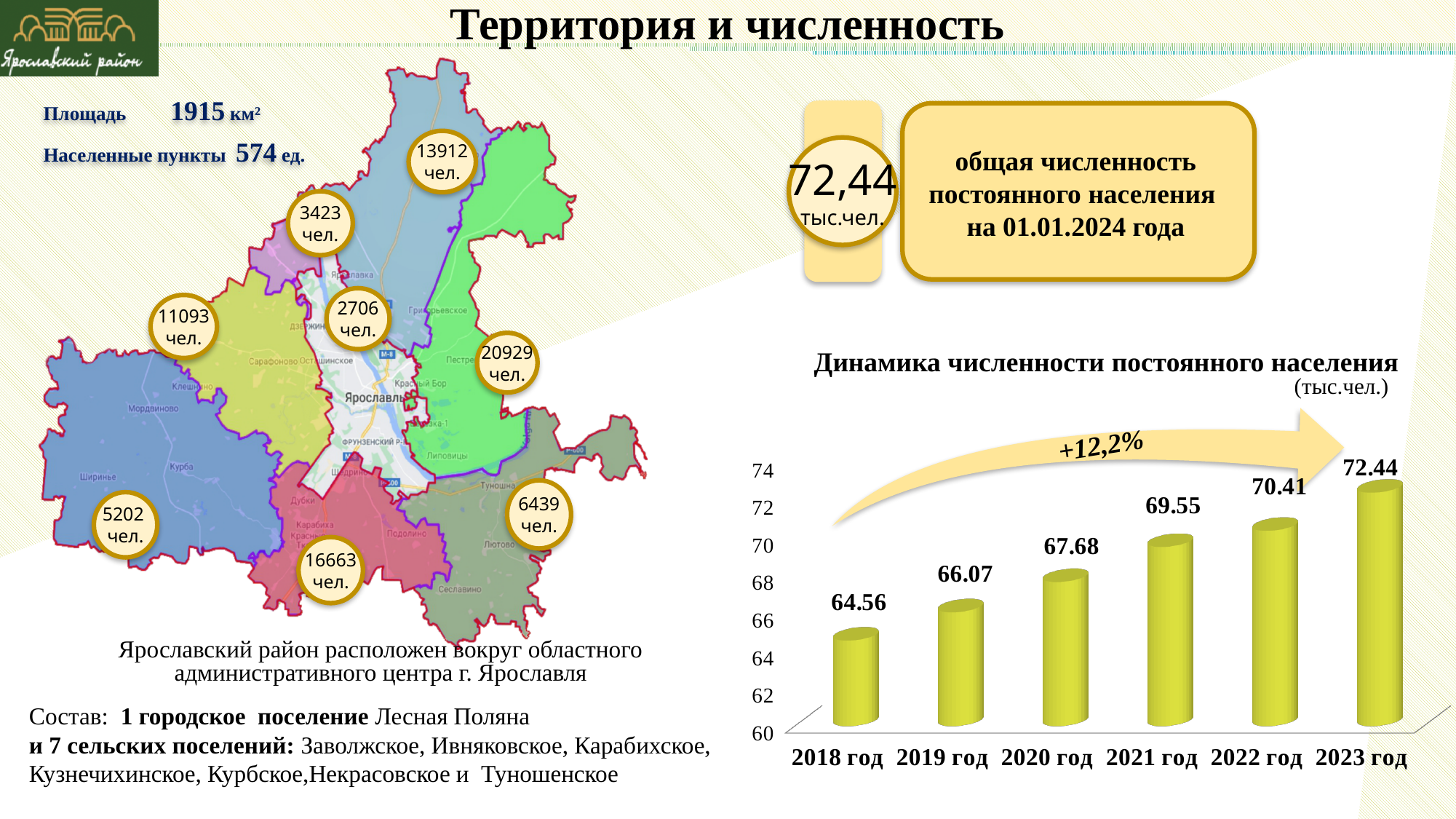
What kind of chart is 'Динамика численности постоянного населения'? bar chart In the chart 'Динамика численности постоянного населения', which is larger: the value for 2022 год or the value for 2020 год? 2022 год What is the value for 2021 год in the chart 'Динамика численности постоянного населения'? 69.55 What is the value for 2018 год in the chart 'Динамика численности постоянного населения'? 64.56 How many years are shown in the chart 'Динамика численности постоянного населения'? 6 Which year has the lowest value in the chart 'Динамика численности постоянного населения'? 2018 год Is the value for 2019 год in the chart 'Динамика численности постоянного населения' greater or less than 68? less What is the difference between the values for 2023 год and 2018 год in the chart 'Динамика численности постоянного населения'? 7.88 What is the value for 2023 год in the chart 'Динамика численности постоянного населения'? 72.44 What is the difference between the values for 2020 год and 2019 год in the chart 'Динамика численности постоянного населения'? 1.61 Which year has the highest value in the chart 'Динамика численности постоянного населения'? 2023 год Do the values in the chart 'Динамика численности постоянного населения' rise or fall from 2018 год to 2023 год? rise